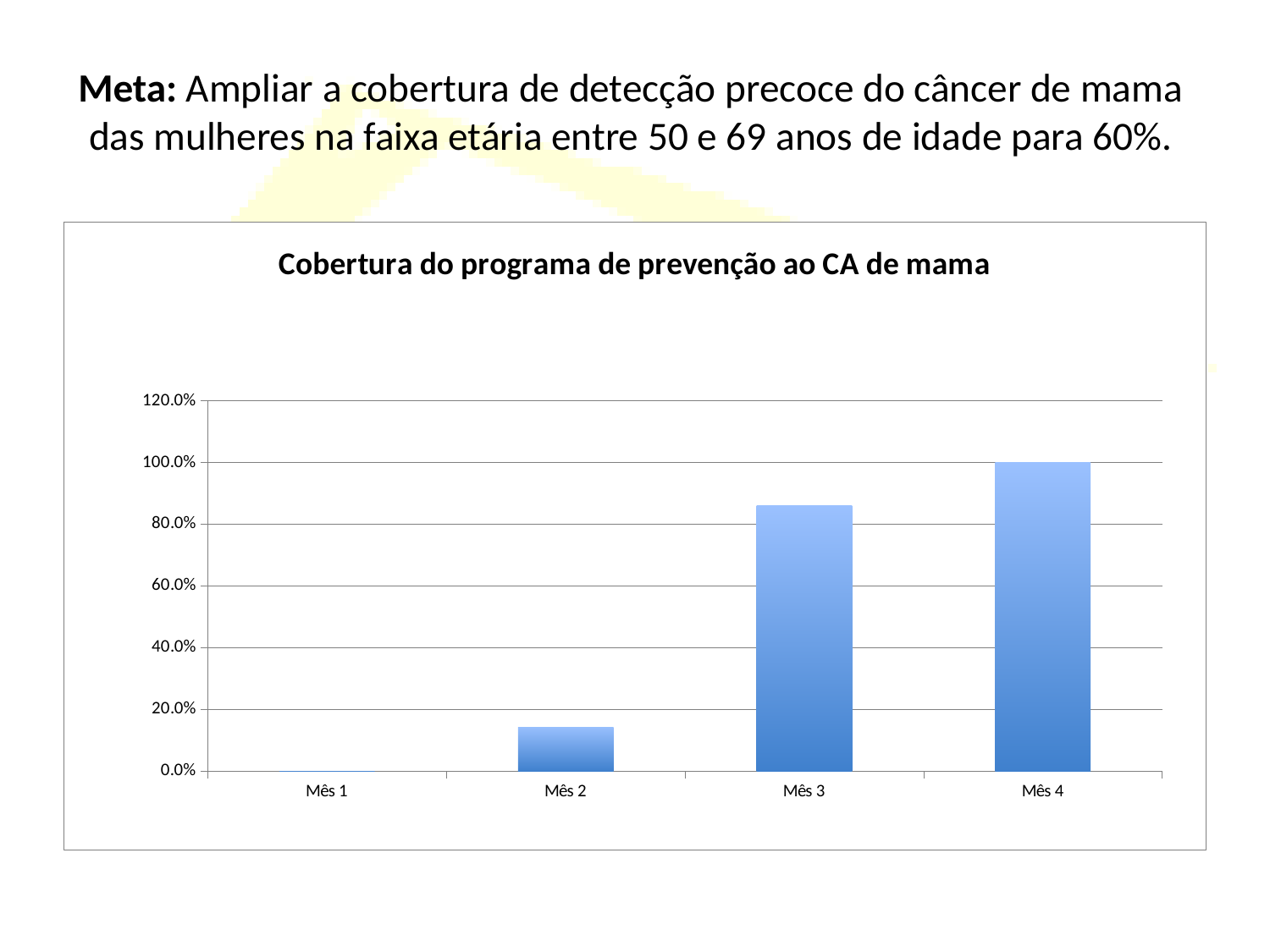
What kind of chart is shown on the slide? bar chart What is the value for Mês 4? 100.0% How many categories are shown on the x axis of the chart? 4 Which is larger, the value for Mês 2 or the value for Mês 3? Mês 3 Is the value for Mês 2 greater or less than 20.0%? less What is the highest value shown on the y axis of the chart? 120.0% Is the value for Mês 3 greater or less than 100.0%? less What is the title of the chart? Cobertura do programa de prevenção ao CA de mama Is the value for Mês 3 greater or less than 80.0%? greater Which month has the highest value in the chart? Mês 4 Do the values rise or fall from Mês 1 to Mês 4? rise Which month has the lowest value in the chart? Mês 1